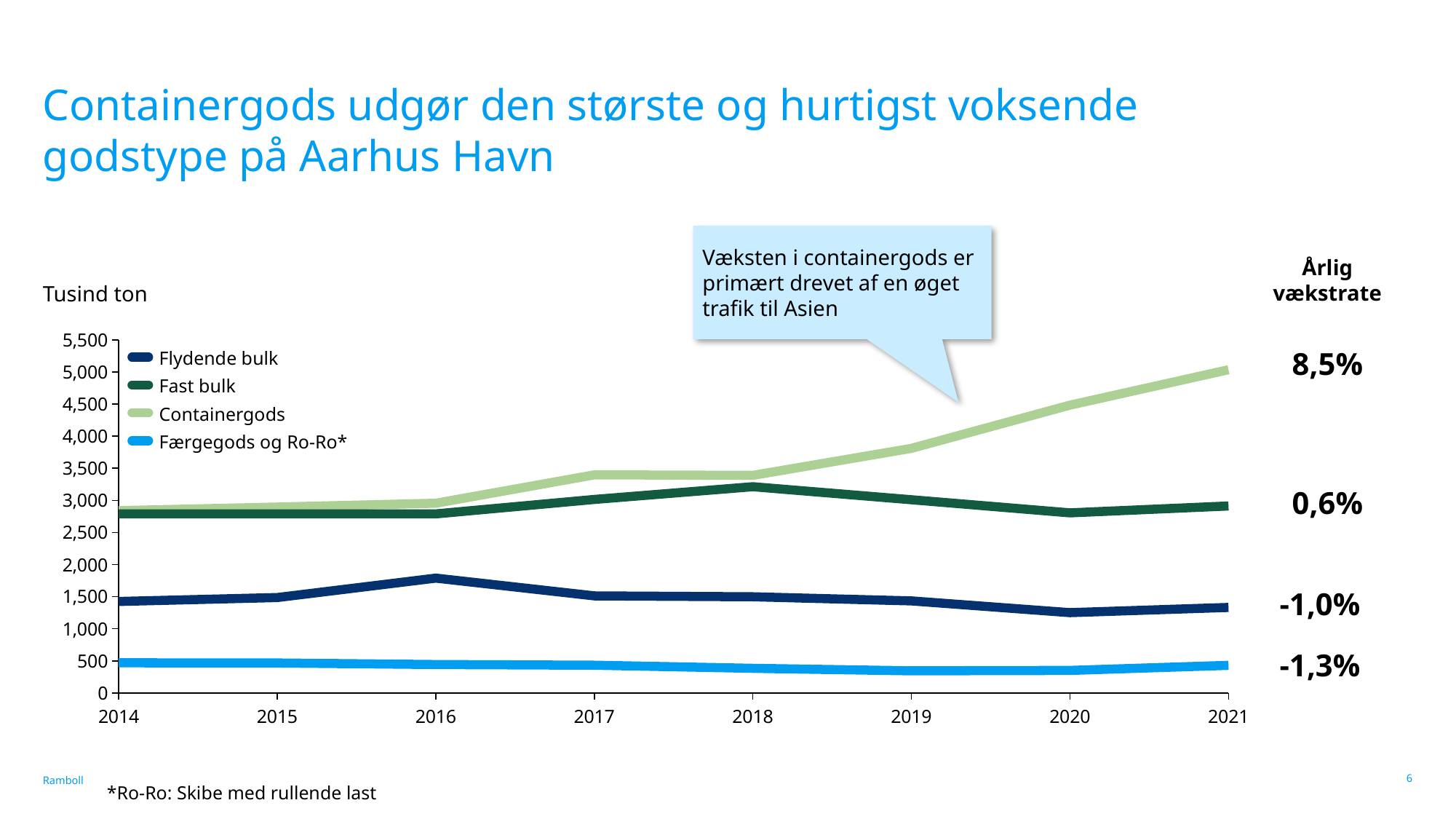
Is the value for Containergods in 2021 greater or less than 4,500? greater Which series has the highest value in 2021? Containergods Does the Containergods line rise or fall from 2018 to 2021? Rise Which series has the lowest value in 2021? Færgegods og Ro-Ro* What kind of chart is shown on the slide? Line chart Is the value for Flydende bulk in 2016 greater or less than 1,500? greater In 2020, which is larger: Fast bulk or Flydende bulk? Fast bulk Is the value for Færgegods og Ro-Ro* in 2019 greater or less than 1,000? less What annual growth rate (Årlig vækstrate) is shown for Containergods? 8,5% What unit is the y axis measured in, according to the label above the chart? Tusind ton How many years are shown on the x axis? 8 How many series does the legend list? 4